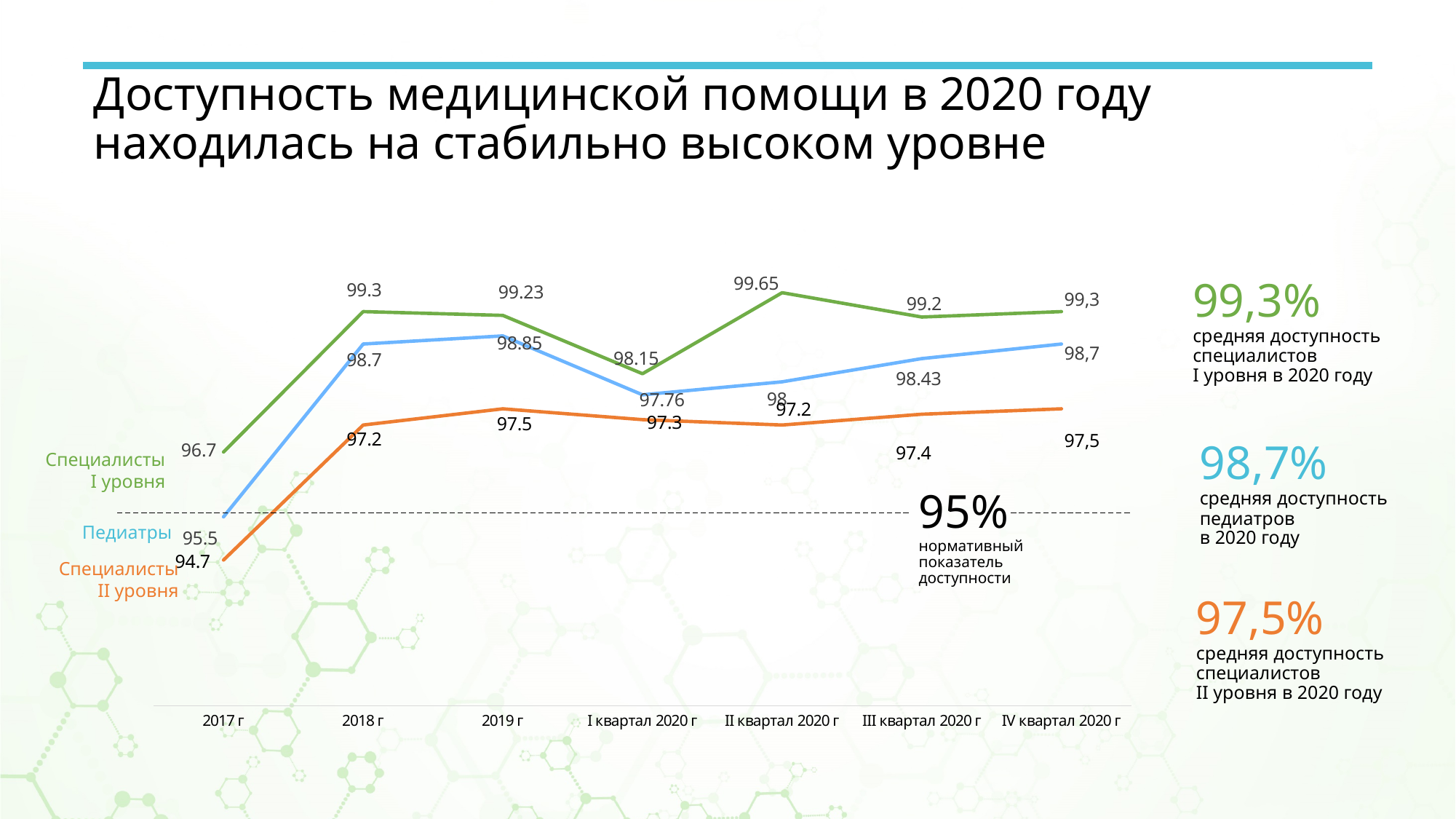
At which x-axis point is the value for Специалисты I уровня highest? II квартал 2020 г What is the value for Специалисты II уровня in III квартал 2020 г? 97.4 What is the value for Педиатры in 2019 г? 98.85 What is the value for Специалисты I уровня in 2017 г? 96.7 How many series are plotted on the chart? 3 What is the difference between the Специалисты I уровня value and the Специалисты II уровня value in 2018 г? 2.1 What value does the dashed horizontal line labelled нормативный показатель доступности mark? 95% What kind of chart is shown on the slide? line chart What is the value for Специалисты I уровня in II квартал 2020 г? 99.65 How many points along the x axis does the chart have? 7 At which x-axis point is the value for Педиатры lowest? 2017 г Which is larger in I квартал 2020 г: the value for Педиатры or the value for Специалисты II уровня? Педиатры